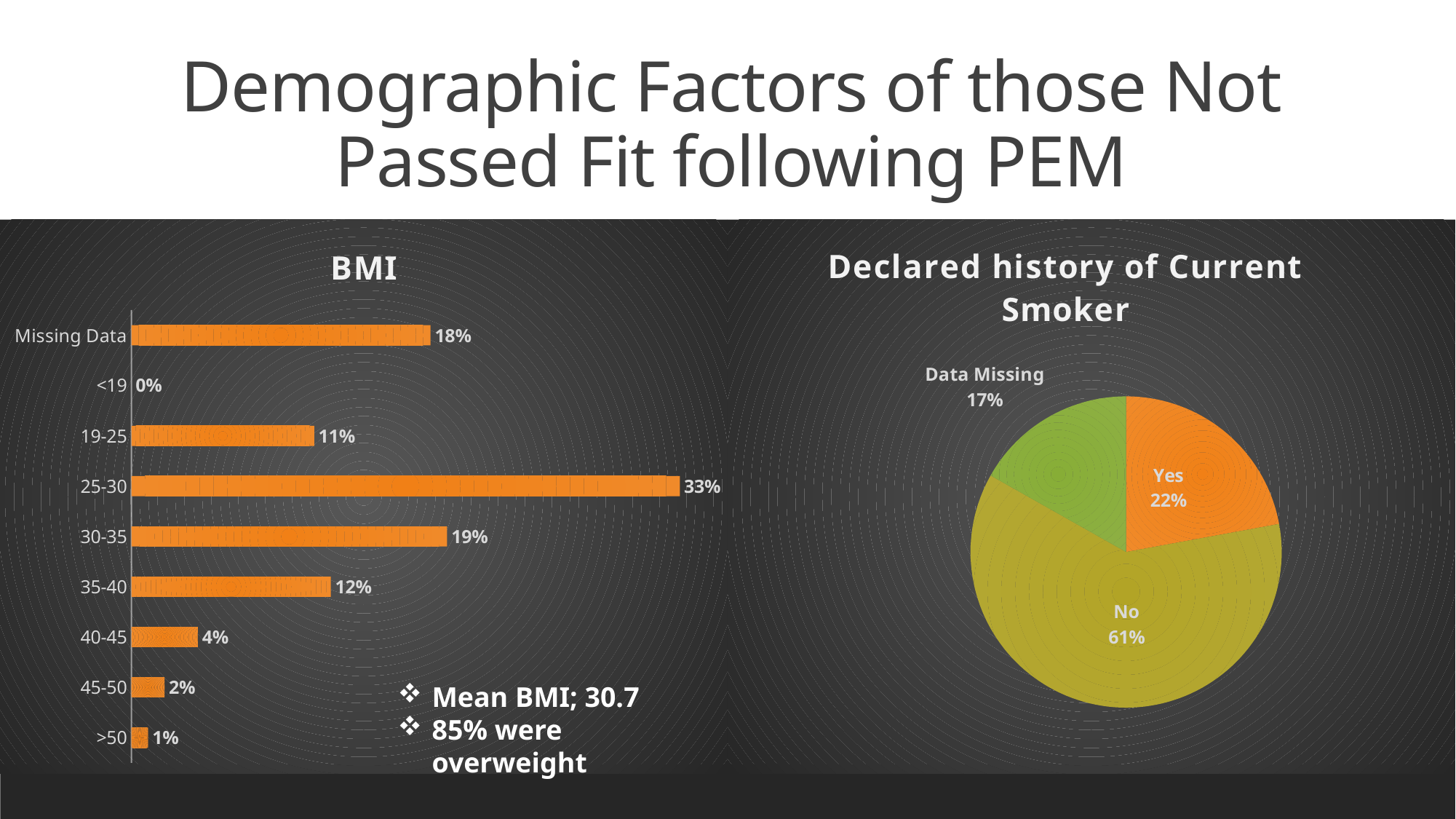
How many categories are shown in the BMI chart? 9 What kind of chart is the Declared history of Current Smoker chart? Pie chart In the Declared history of Current Smoker chart, which slice is the smallest? Data Missing In the Declared history of Current Smoker chart, what share of the pie is 'No'? 61% In the Declared history of Current Smoker chart, what is the value for 'Yes'? 22% In the BMI chart, what is the value for the 25-30 category? 33% In the BMI chart, which BMI category has the highest value? 25-30 In the BMI chart, what is the difference between the 30-35 and 35-40 values? 7% In the BMI chart, which is larger, the value for 19-25 or the value for 40-45? 19-25 In the BMI chart, which category has the lowest value? <19 What kind of chart is the BMI chart? Bar chart In the BMI chart, what is the value for Missing Data? 18%